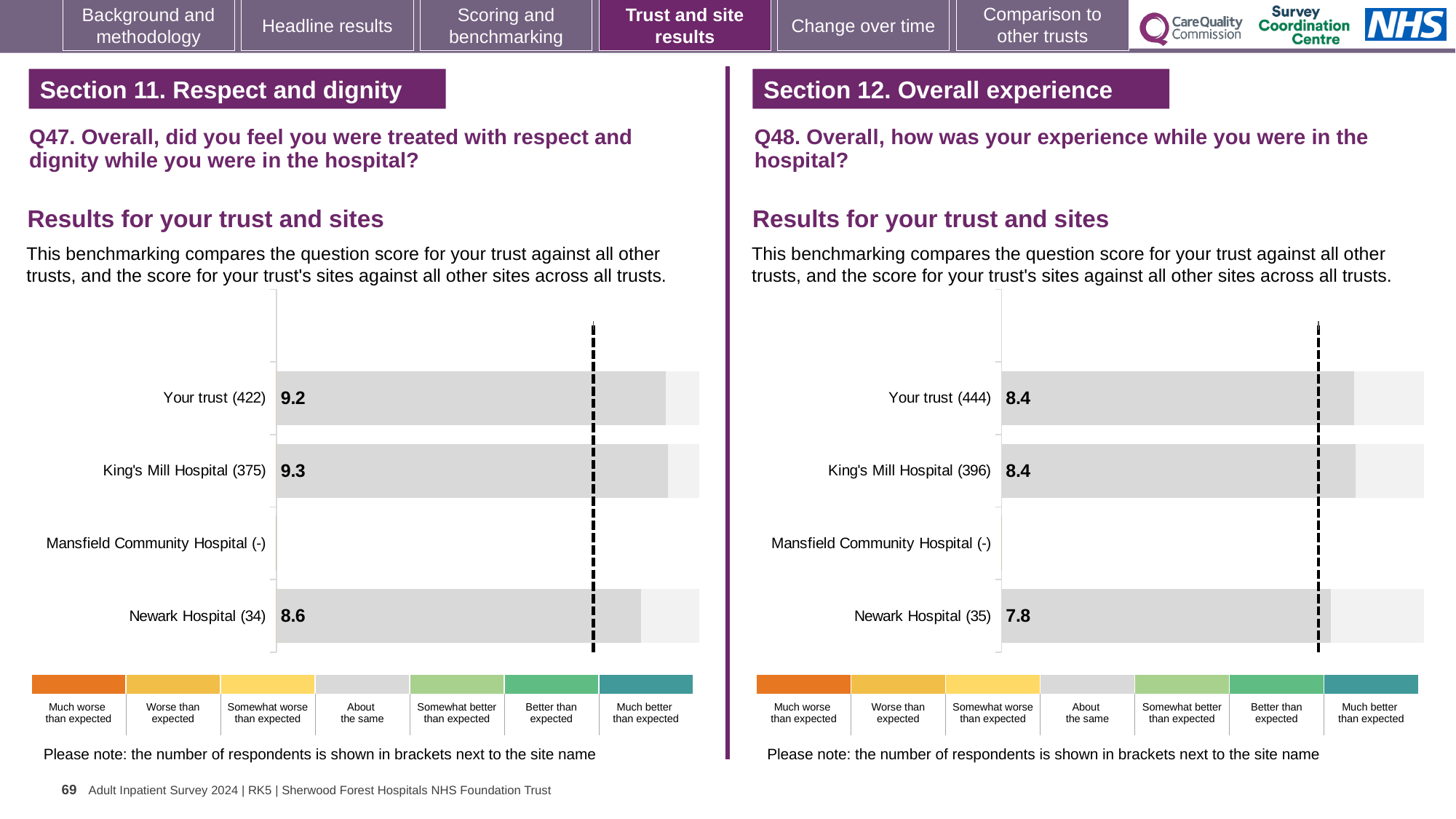
In the Q48 chart on the right, what is the difference between the Your trust score and the Newark Hospital score? 0.6 In the Q48 chart on the right, what is the score for Newark Hospital? 7.8 In the Q47 chart on the left, which is larger: the score for King's Mill Hospital or the score for Newark Hospital? King's Mill Hospital In the Q47 chart on the left, what is the score for Your trust? 9.2 In the Q48 chart on the right, which site has the lowest score? Newark Hospital How many sites or rows are listed in the Q48 chart on the right? 4 In the Q47 chart on the left, what is the difference between the King's Mill Hospital score and the Newark Hospital score? 0.7 In the Q47 chart on the left, which site has the lowest score? Newark Hospital What type of chart is used in the Q47 chart on the left? Bar chart In the Q47 chart on the left, what is the score for King's Mill Hospital? 9.3 In the Q48 chart on the right, what is the score for Your trust? 8.4 In the Q47 chart on the left, what is the score for Newark Hospital? 8.6